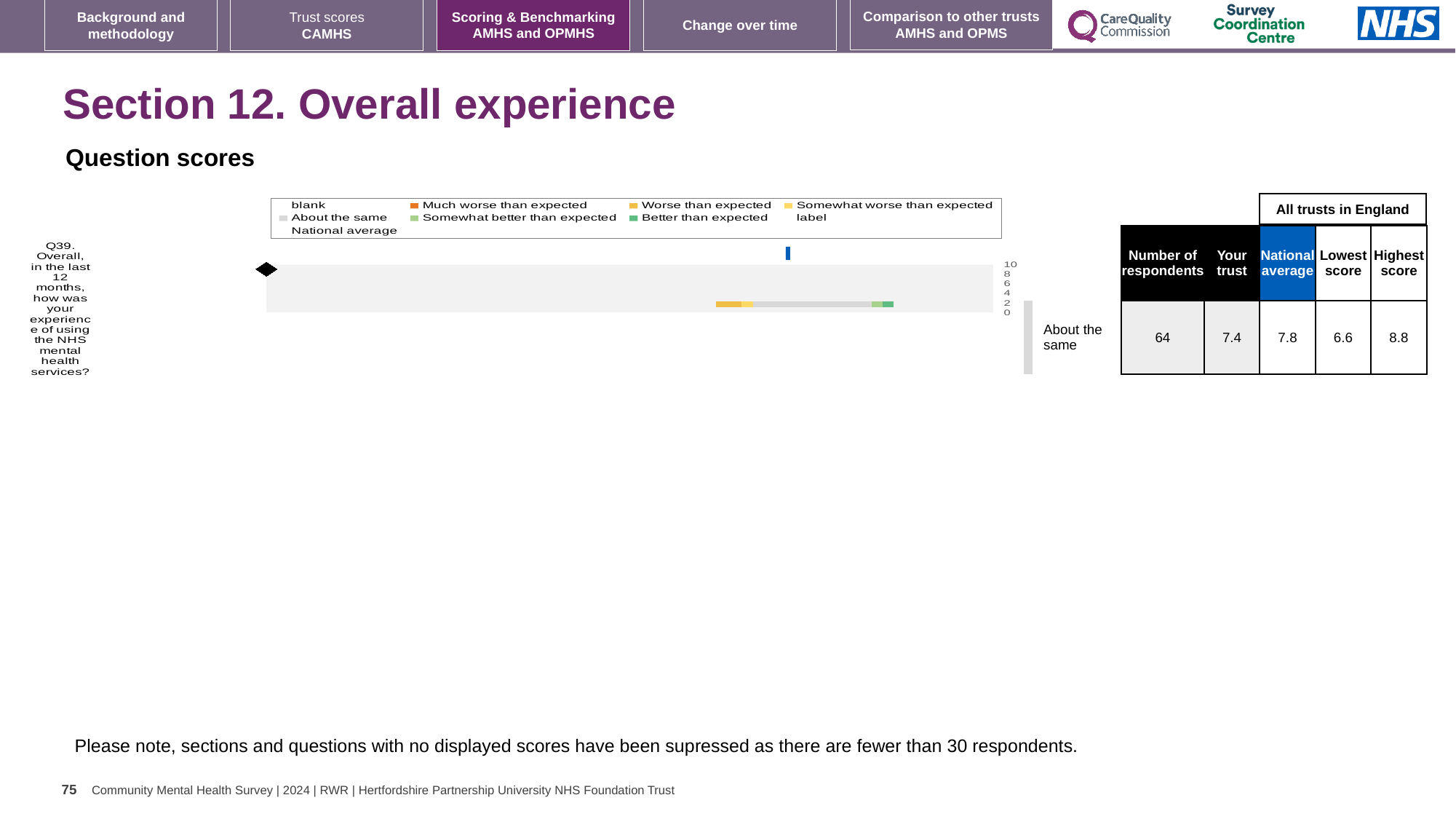
How many questions (categories) are plotted in the chart? 1 What is the difference between the highest score and the lowest score for Q39? 2.2 According to the table beside the chart, what is the national average score for Q39? 7.8 What kind of chart is shown on the slide for Q39? bar chart According to the table beside the chart, what is the highest score among all trusts in England for Q39? 8.8 According to the table beside the chart, what is the number of respondents for Q39? 64 Which question is plotted in the chart? Q39. Overall, in the last 12 months, how was your experience of using the NHS mental health services? According to the table beside the chart, what is the 'Your trust' score for Q39? 7.4 What benchmark category label is shown next to the chart for Q39? About the same According to the table beside the chart, what is the lowest score among all trusts in England for Q39? 6.6 What is the maximum value shown on the chart's vertical axis? 10 Which is larger for Q39, the 'Your trust' score or the national average? National average